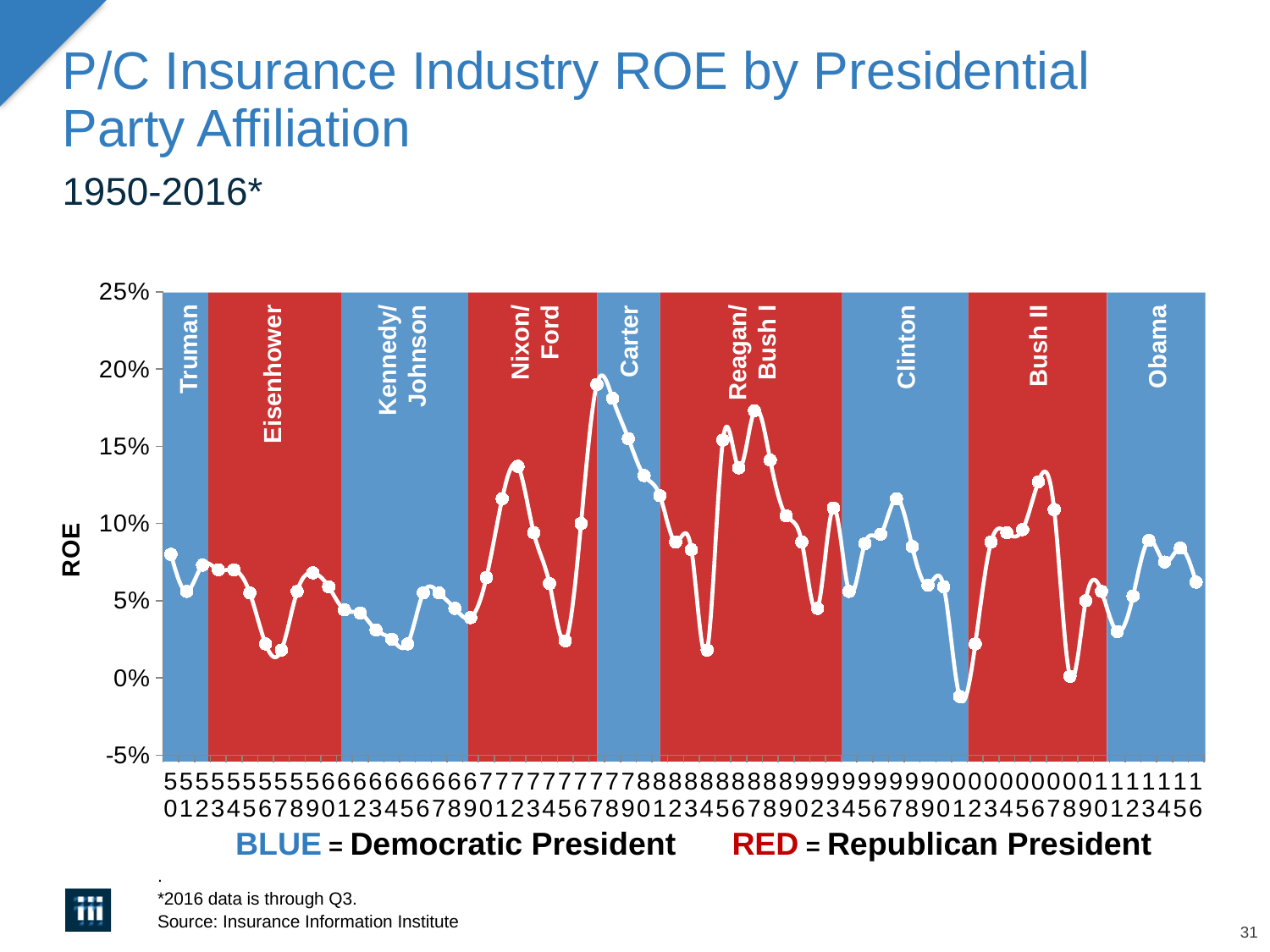
Does the ROE generally rise or fall from 1950 to 1957? fall Is the ROE value for 1984 greater or less than 10%? less Is the ROE value for 1977 greater or less than 15%? greater According to the chart's key, what does a red background represent? Republican President Is the ROE value for 1987 greater or less than 10%? greater Does the ROE generally rise or fall from 1974 to 1977? rise How many presidential periods are labeled across the chart? 9 What kind of chart is shown on the slide? line chart What is the label on the vertical axis of the chart? ROE